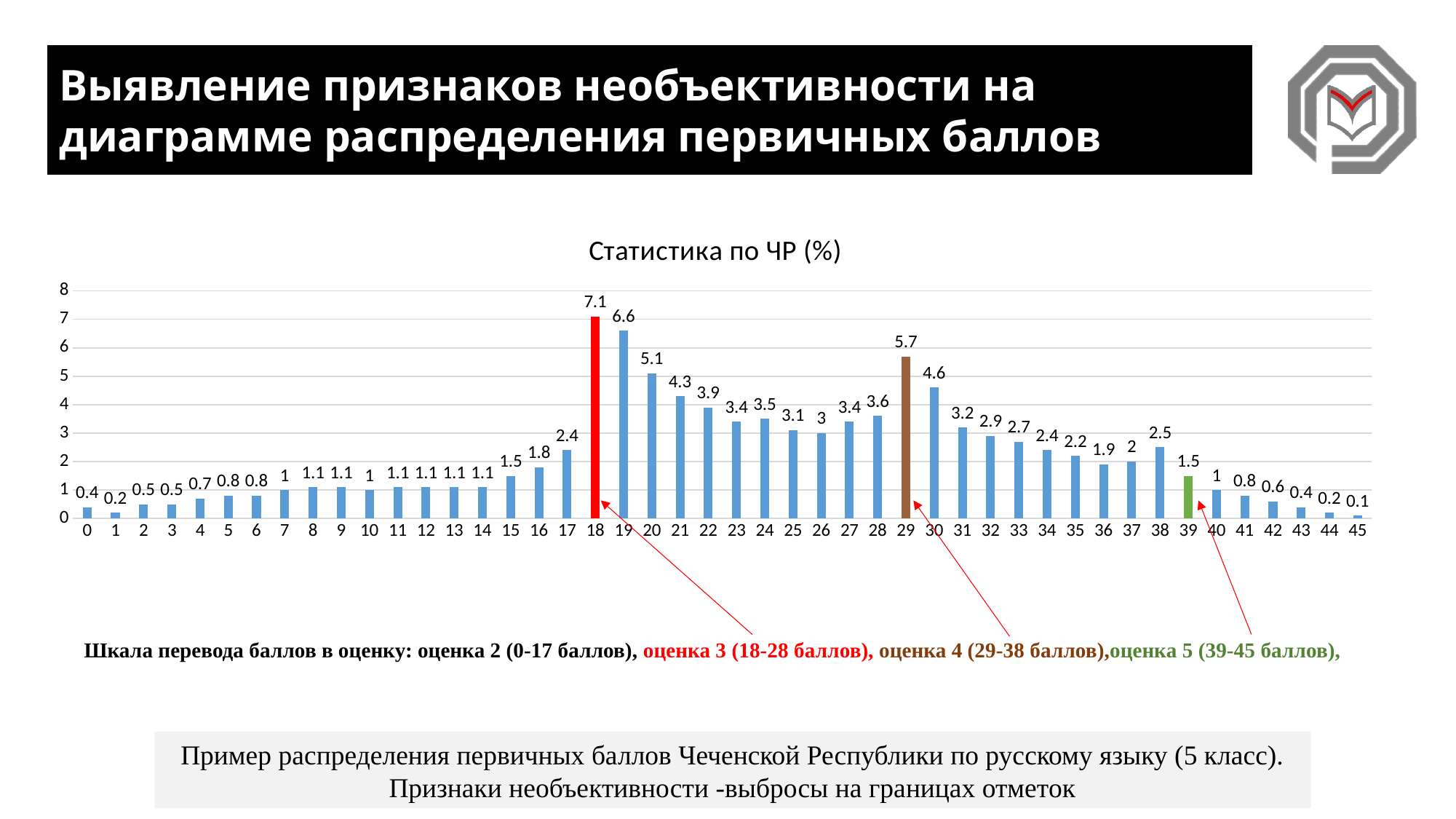
What is the value for score 29? 5.7 What is the value for score 39? 1.5 What is the title of the chart? Статистика по ЧР (%) How many score categories are shown on the x axis? 46 Which score has the lowest value? 45 Which is larger, the value for score 29 or the value for score 30? 29 What is the value for score 18? 7.1 What colour is the bar for score 18? red Which score has the highest value? 18 What kind of chart is shown on the slide? bar chart Is the value for score 18 greater or less than 6? greater What is the difference between the values for score 18 and score 19? 0.5